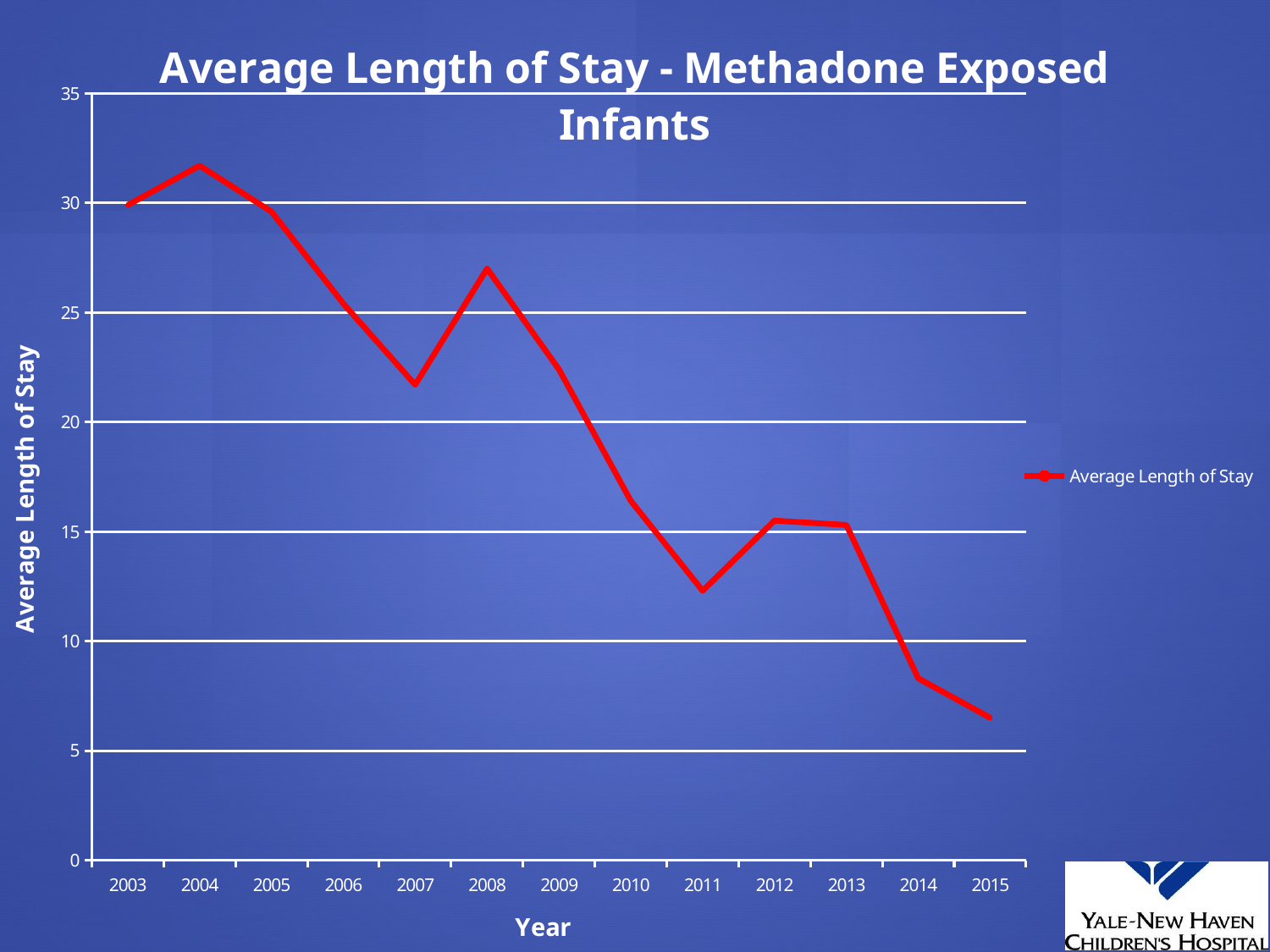
Which year has a larger average length of stay, 2007 or 2008? 2008 What is the title of the chart? Average Length of Stay - Methadone Exposed Infants How many series does the legend list? 1 Which year has a larger average length of stay, 2011 or 2014? 2011 Is the value for 2014 greater or less than 10? less Which year has the lowest average length of stay? 2015 What type of chart is shown on the slide? line chart How many years are plotted on the x axis? 13 Which year has the highest average length of stay? 2004 Is the value for 2007 greater or less than 25? less Overall, does the average length of stay rise or fall from 2003 to 2015? fall Is the value for 2008 greater or less than 25? greater